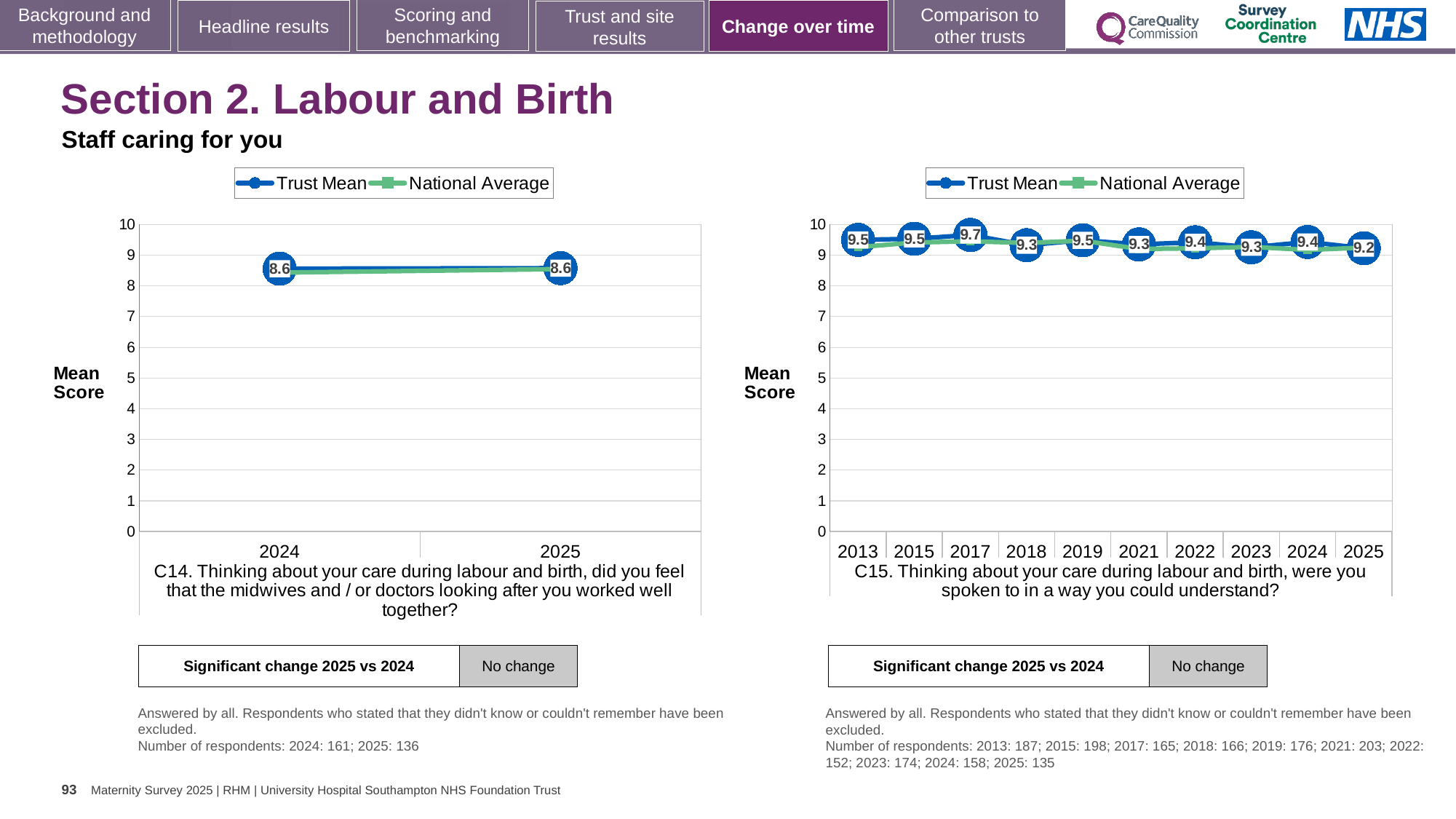
On the C15 chart (right), what is the difference between the Trust Mean for 2017 and the Trust Mean for 2025? 0.5 On the C15 chart (right), what is the Trust Mean for 2025? 9.2 On the C15 chart (right), how many years are shown on the x axis? 10 On the C14 chart (left), how many years are shown on the x axis? 2 On the C15 chart (right), what is the Trust Mean for 2017? 9.7 On the C15 chart (right), which year has the highest Trust Mean? 2017 On the C15 chart (right), is the Trust Mean for 2018 larger or smaller than the Trust Mean for 2019? smaller What kind of chart is the C15 chart (right)? line chart On the C14 chart (left), what is the Trust Mean for 2025? 8.6 On the C15 chart (right), which year has the lowest Trust Mean? 2025 On the C14 chart (left), how many series does the legend list? 2 On the C14 chart (left), what is the Trust Mean for 2024? 8.6